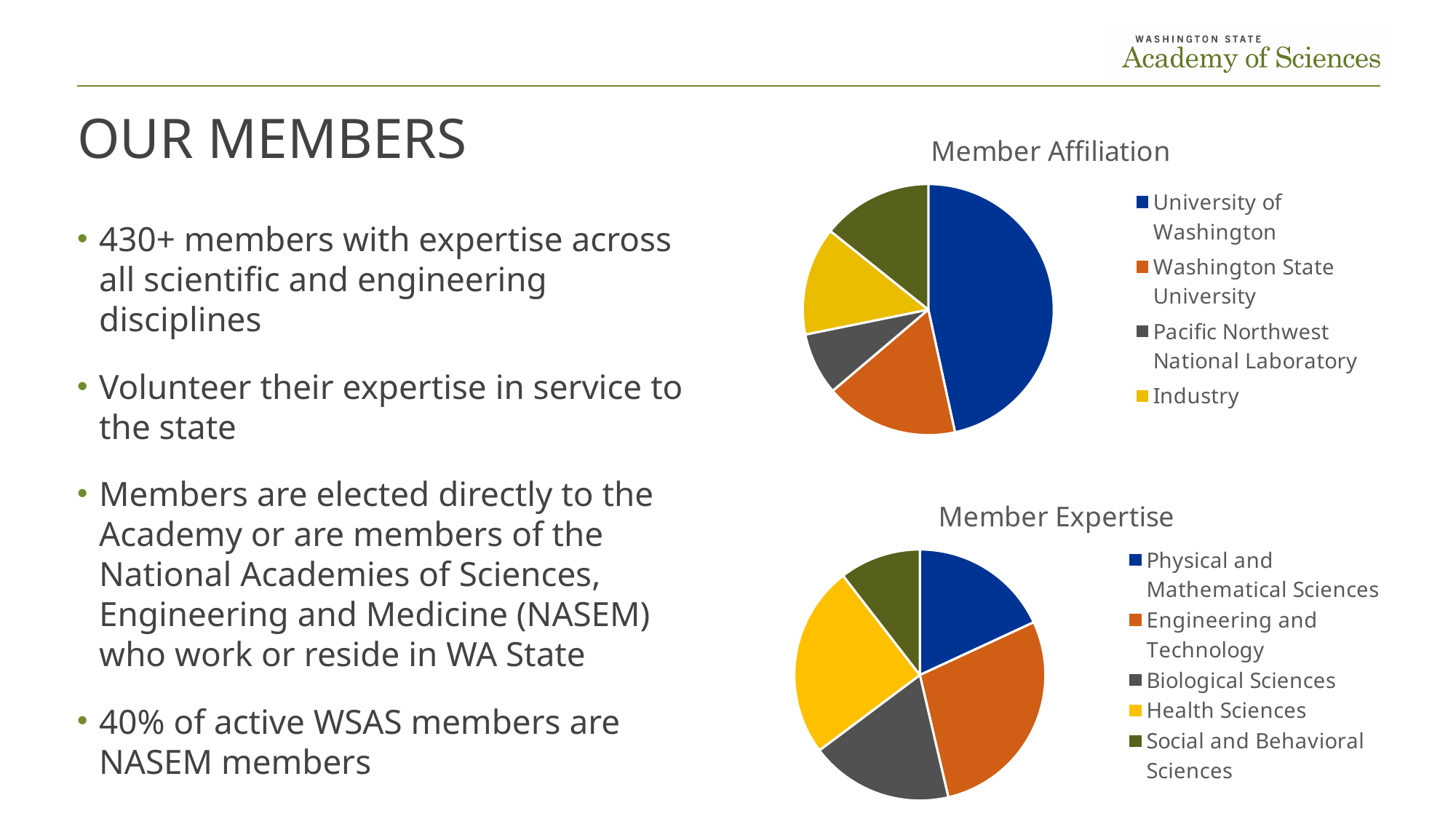
How many expertise categories does the Member Expertise chart's legend list? 5 What kind of chart is the Member Affiliation chart? pie chart How many entries does the legend of the Member Affiliation chart list? 4 In the Member Expertise chart, which slice is larger: Health Sciences or Social and Behavioral Sciences? Health Sciences In the Member Expertise chart, what colour is the Health Sciences slice? yellow What kind of chart is the Member Expertise chart? pie chart What is the title of the upper pie chart on the slide? Member Affiliation In the Member Affiliation chart, which slice is larger: University of Washington or Washington State University? University of Washington In the Member Expertise chart, which expertise area has the largest slice? Engineering and Technology In the Member Expertise chart, which expertise area has the smallest slice? Social and Behavioral Sciences In the Member Affiliation chart, which affiliation has the largest slice? University of Washington In the Member Affiliation chart, which labeled affiliation has the smallest slice? Pacific Northwest National Laboratory